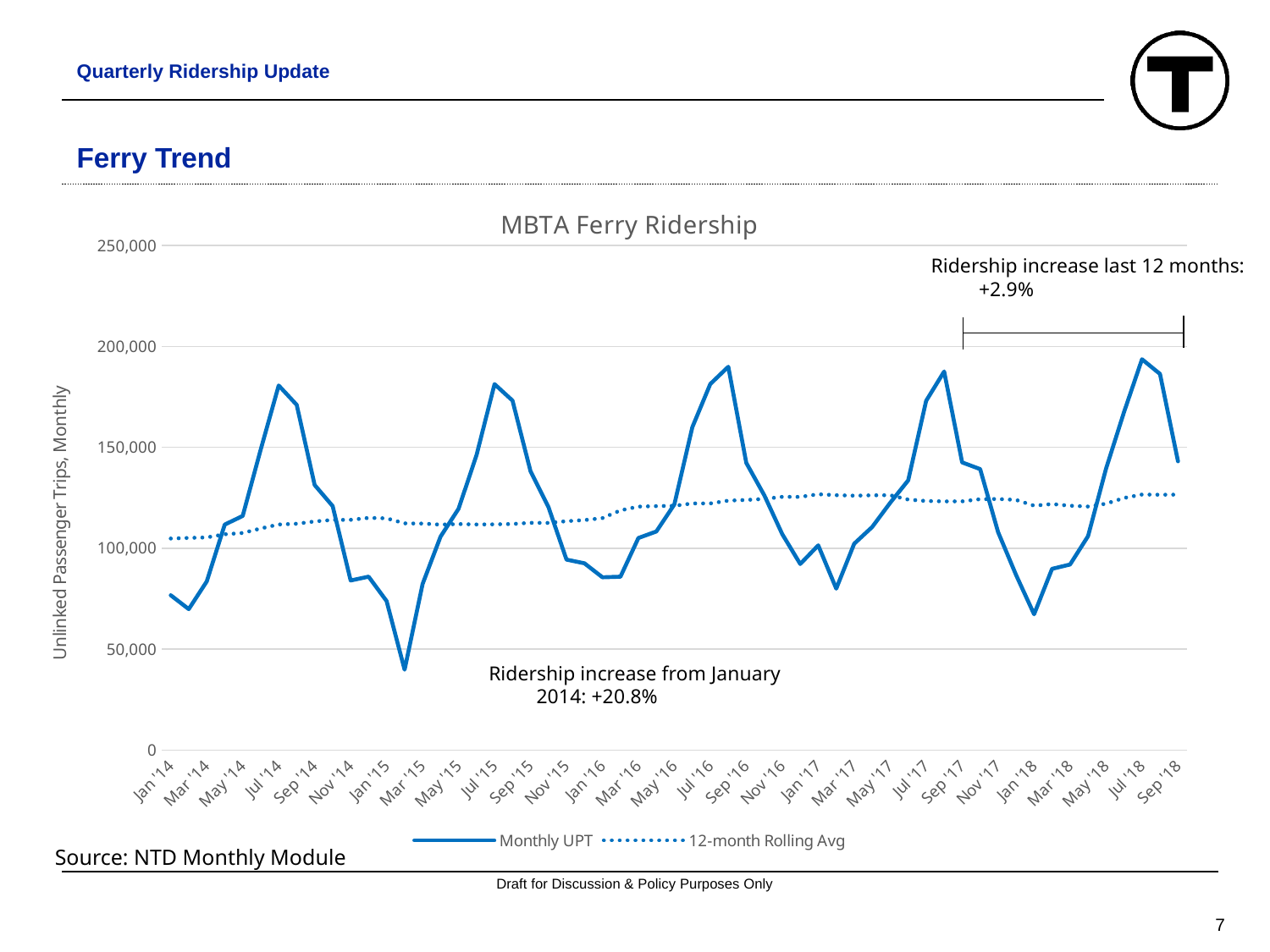
Is the Monthly UPT value for Jan '14 greater or less than 100,000? less What is the title of the chart? MBTA Ferry Ridership Is the 12-month Rolling Avg value for Sep '18 greater or less than 150,000? less Is the Monthly UPT value for Jul '14 greater or less than 150,000? greater Does the 12-month Rolling Avg line generally rise or fall from Jan '14 to Sep '18? rise How many series does the legend of the MBTA Ferry Ridership chart list? 2 What kind of chart is shown on the slide? Line chart According to the annotation on the chart, what is the ridership increase over the last 12 months? +2.9% What is the label on the vertical axis of the chart? Unlinked Passenger Trips, Monthly According to the annotation on the chart, what is the ridership increase from January 2014? +20.8% Which is larger, the Monthly UPT value for Jul '18 or for Jan '18? Jul '18